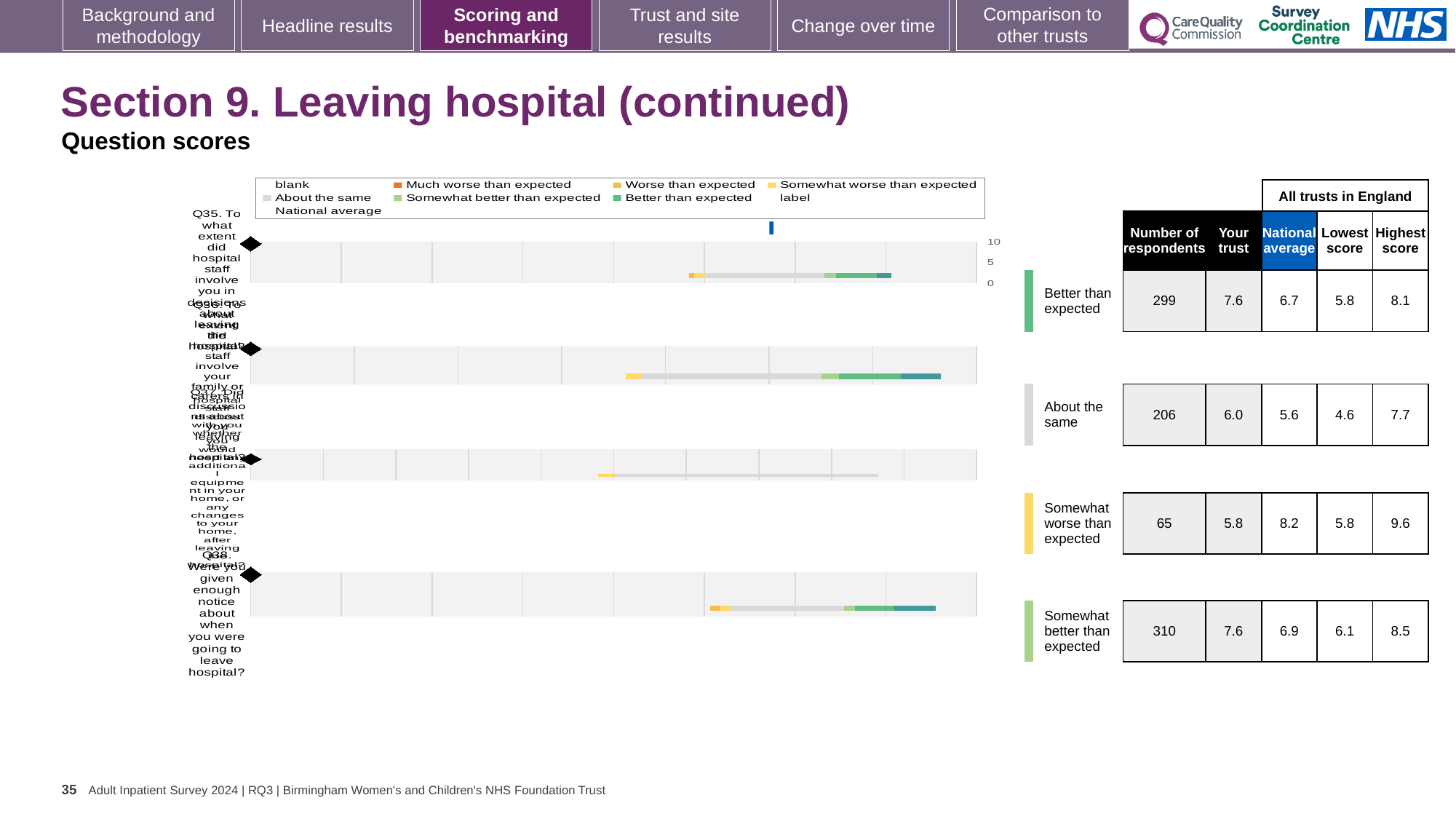
In the table on the right, what is the lowest score for the 'About the same' row? 4.6 In the table on the right, what is the 'Your trust' score for the 'Better than expected' row? 7.6 In the table on the right, which row has the lowest 'Your trust' score? Somewhat worse than expected In the table on the right, what is the national average for the 'Somewhat worse than expected' row? 8.2 In the table on the right, which row has the highest number of respondents? Somewhat better than expected In the table on the right, for the 'Somewhat worse than expected' row, which is larger: the 'Your trust' score or the national average? National average In the table on the right, what is the difference between the 'Your trust' score and the national average for the 'Better than expected' row? 0.9 In the table on the right, what is the highest score for the 'Somewhat better than expected' row? 8.5 In the table on the right, how many respondents are shown for the 'About the same' row? 206 How many entries does the chart legend list? 9 How many survey questions (Q35 to Q38) are plotted in the chart? 4 What kind of chart is shown on the left of the slide? bar chart